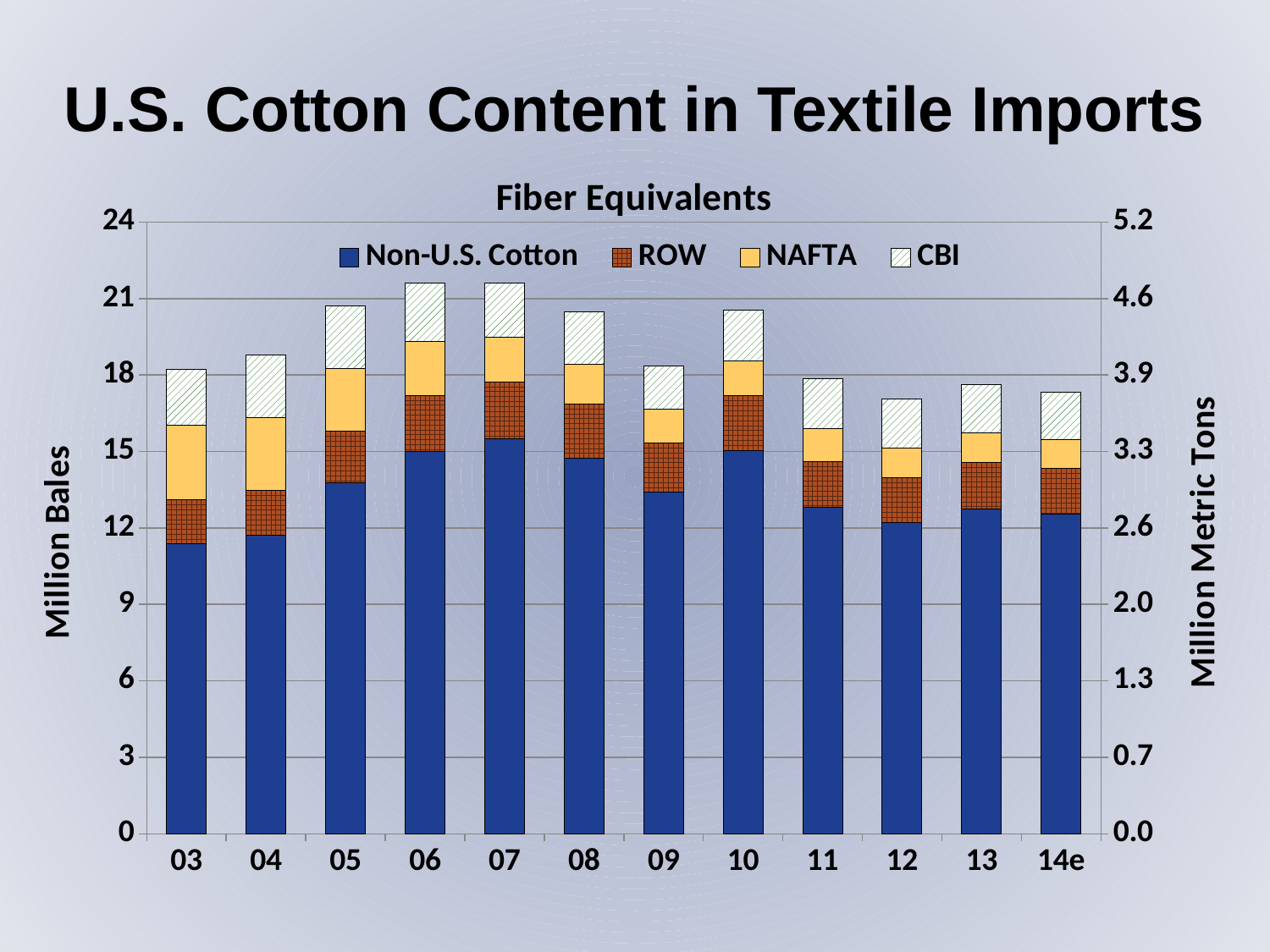
Is the Non-U.S. Cotton value for 07 greater or less than 15 million bales? greater What kind of chart is shown on the slide? Stacked bar chart Is the total height of the stacked bar for 12 greater or less than 18 million bales? less Is the Non-U.S. Cotton value for 03 greater or less than 12 million bales? less Which has the taller total stacked bar, 06 or 12? 06 What is the title of the left vertical axis? Million Bales Do the total stacked bar heights rise or fall from 10 to 12? fall How many series does the chart's legend list? 4 Which has the taller total stacked bar, 10 or 11? 10 How many years (categories) are shown on the x axis of the chart? 12